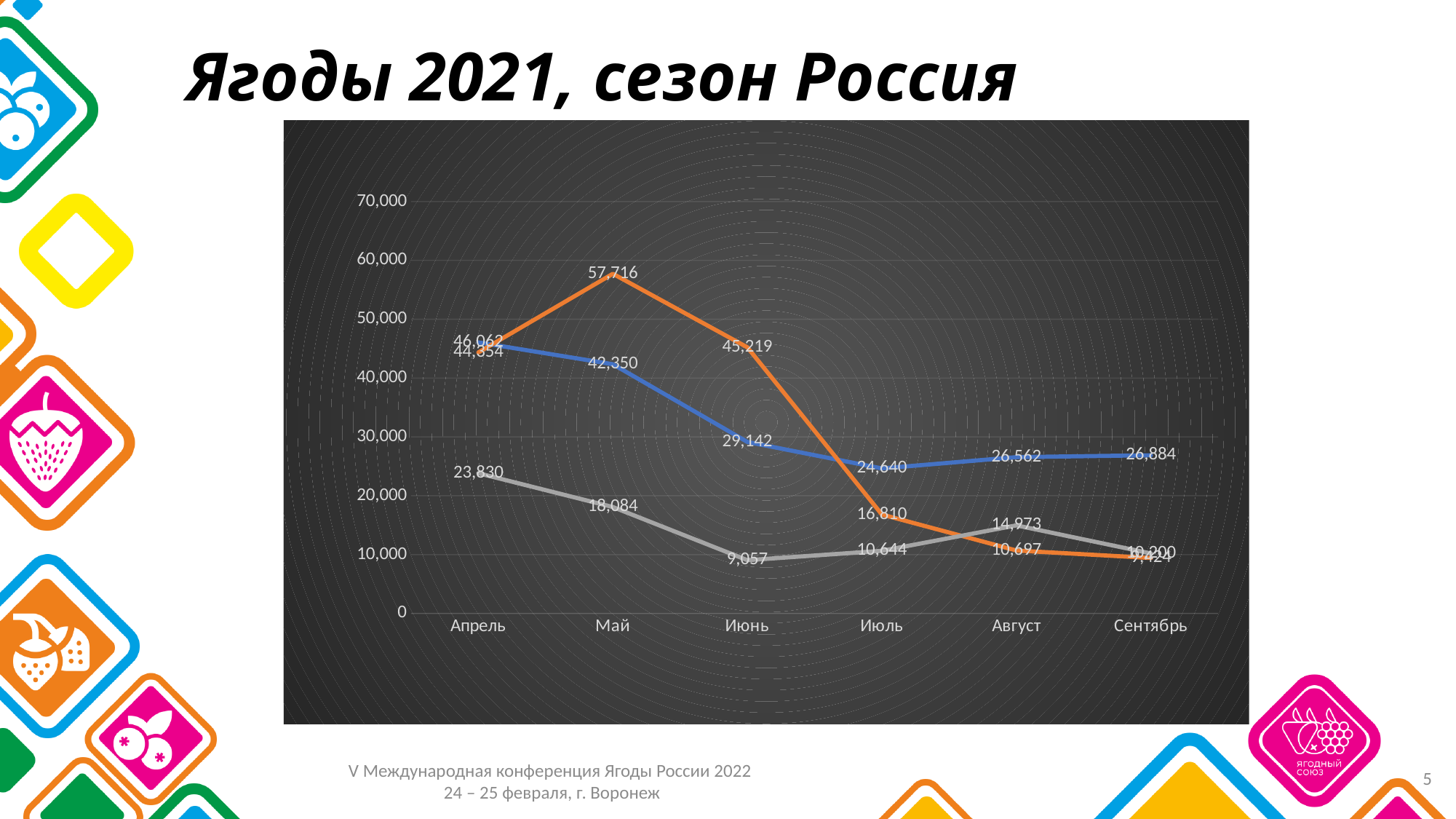
Which is larger in Июль (July): the blue line's value or the orange line's value? the blue line (24,640) Is the grey line's value in Август greater or less than 20,000? less What is the value of the blue line in Июнь (June)? 29,142 What is the difference between the orange line's value in Май (57,716) and in Июнь (45,219)? 12,497 What kind of chart is shown on the slide? line chart What is the title of the slide containing the chart? Ягоды 2021, сезон Россия In which month does the orange line reach its highest value? Май What is the value of the grey line in Апрель (April)? 23,830 Does the blue line rise or fall from Апрель to Июль? fall How many months are shown on the x axis of the chart? 6 What is the value of the orange line in Май (May)? 57,716 In which month does the grey line reach its lowest value? Июнь